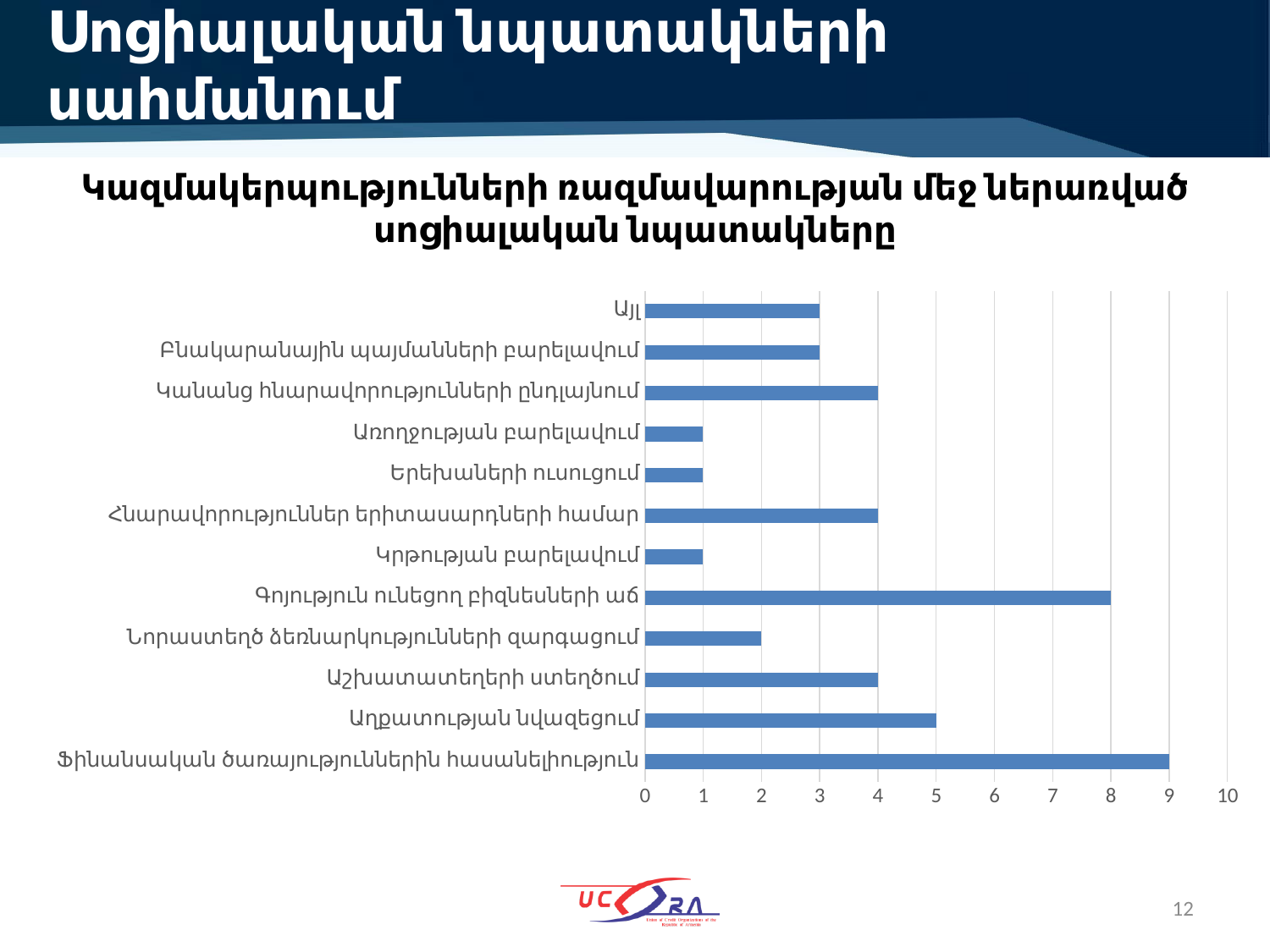
What is the value for Ֆինանսական ծառայություններին հասանելիություն? 9 What is the value for Աղքատության նվազեցում? 5 Which category has the highest value in the chart? Ֆինանսական ծառայություններին հասանելիություն What is the maximum value shown on the horizontal axis of the chart? 10 What is the value for Գոյություն ունեցող բիզնեսների աճ? 8 Is the value for Աղքատության նվազեցում greater or less than 4? greater Which is larger, the value for Աշխատատեղերի ստեղծում or the value for Այլ? Աշխատատեղերի ստեղծում How many categories are plotted in the chart? 12 What is the value for Նորաստեղծ ձեռնարկությունների զարգացում? 2 What type of chart is shown on the slide? bar chart What is the value for Կրթության բարելավում? 1 What is the difference between the values for Ֆինանսական ծառայություններին հասանելիություն and Գոյություն ունեցող բիզնեսների աճ? 1